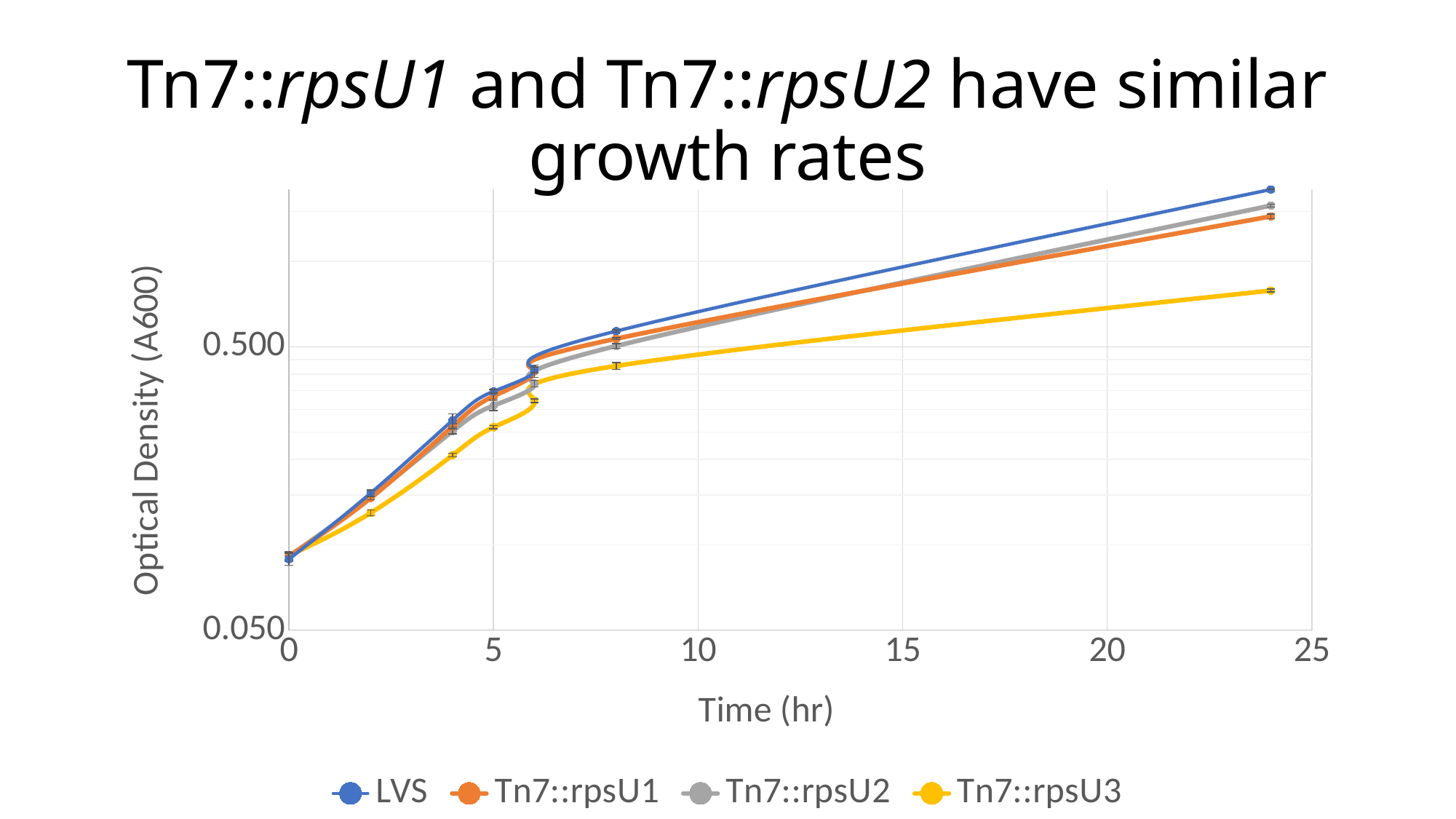
Is the optical density of LVS at 24 hours greater or less than 0.500? greater Which series has the highest optical density at 24 hours? LVS Is the optical density of Tn7::rpsU3 at 8 hours greater or less than 0.500? less What is the label of the x axis? Time (hr) How many time points are plotted for each series? 7 Is the optical density of LVS at 4 hours greater or less than 0.500? less Which series has the lowest optical density at 24 hours? Tn7::rpsU3 Do the optical density values rise or fall as time increases? rise At 24 hours, which is larger, the optical density of LVS or of Tn7::rpsU3? LVS How many series does the legend list? 4 What kind of chart is shown on the slide? line chart